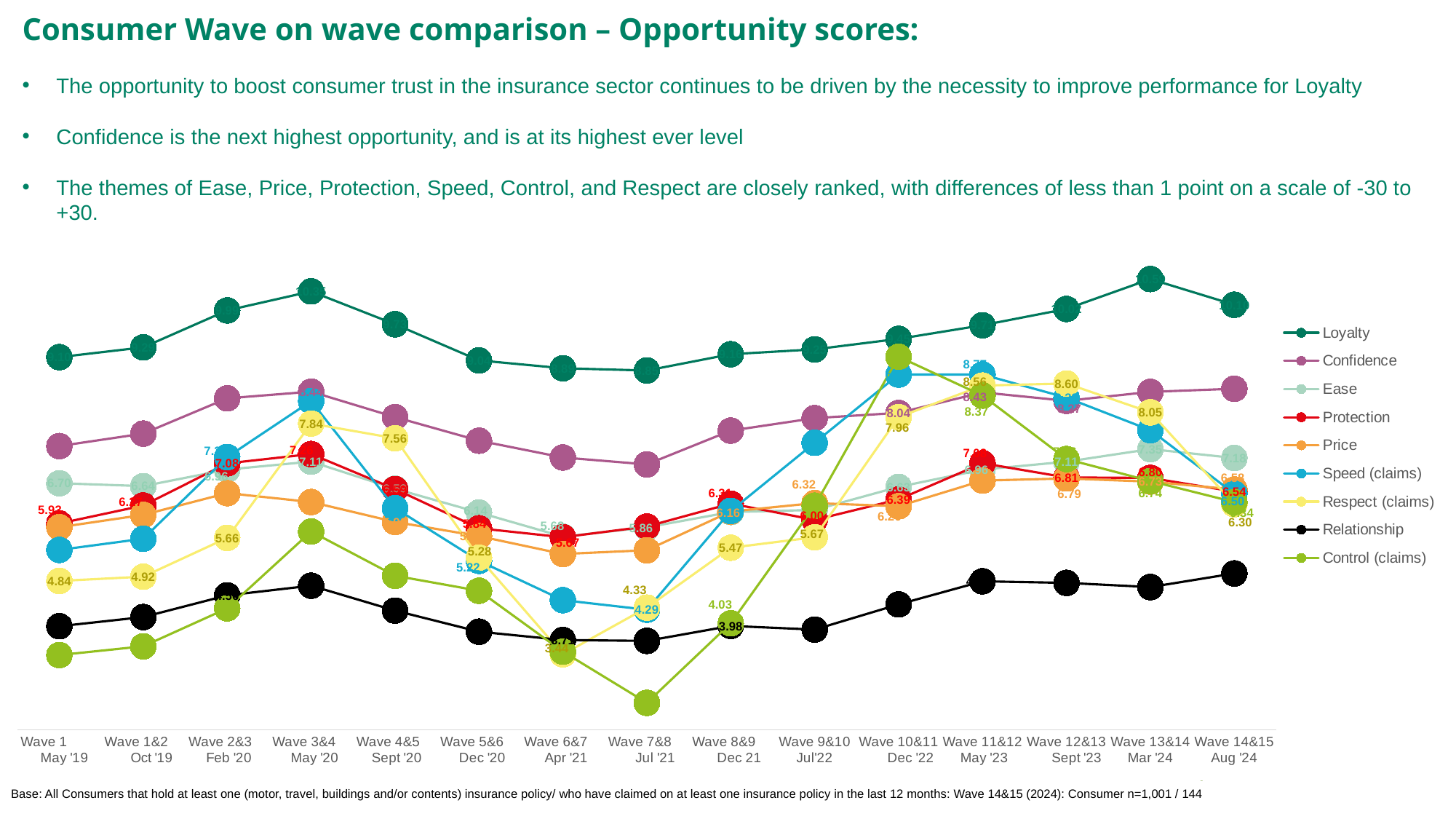
How many waves are shown along the x axis? 15 What is the value for Respect (claims) at Wave 1 May '19? 4.84 What is the difference between the Respect (claims) value at Wave 12&13 Sept '23 and at Wave 1 May '19? 3.76 What is the value for Respect (claims) at Wave 12&13 Sept '23? 8.60 Does the Loyalty line rise or fall from Wave 7&8 Jul '21 to Wave 13&14 Mar '24? rise How many series does the legend list? 9 Which series has the lowest value at Wave 7&8 Jul '21? Control (claims) What type of chart is shown on the slide? line chart Which series has the highest value at Wave 14&15 Aug '24? Loyalty What is the value for Price at Wave 9&10 Jul'22? 6.32 What is the value for Relationship at Wave 8&9 Dec 21? 3.98 At Wave 3&4 May '20, which is larger: Loyalty or Confidence? Loyalty